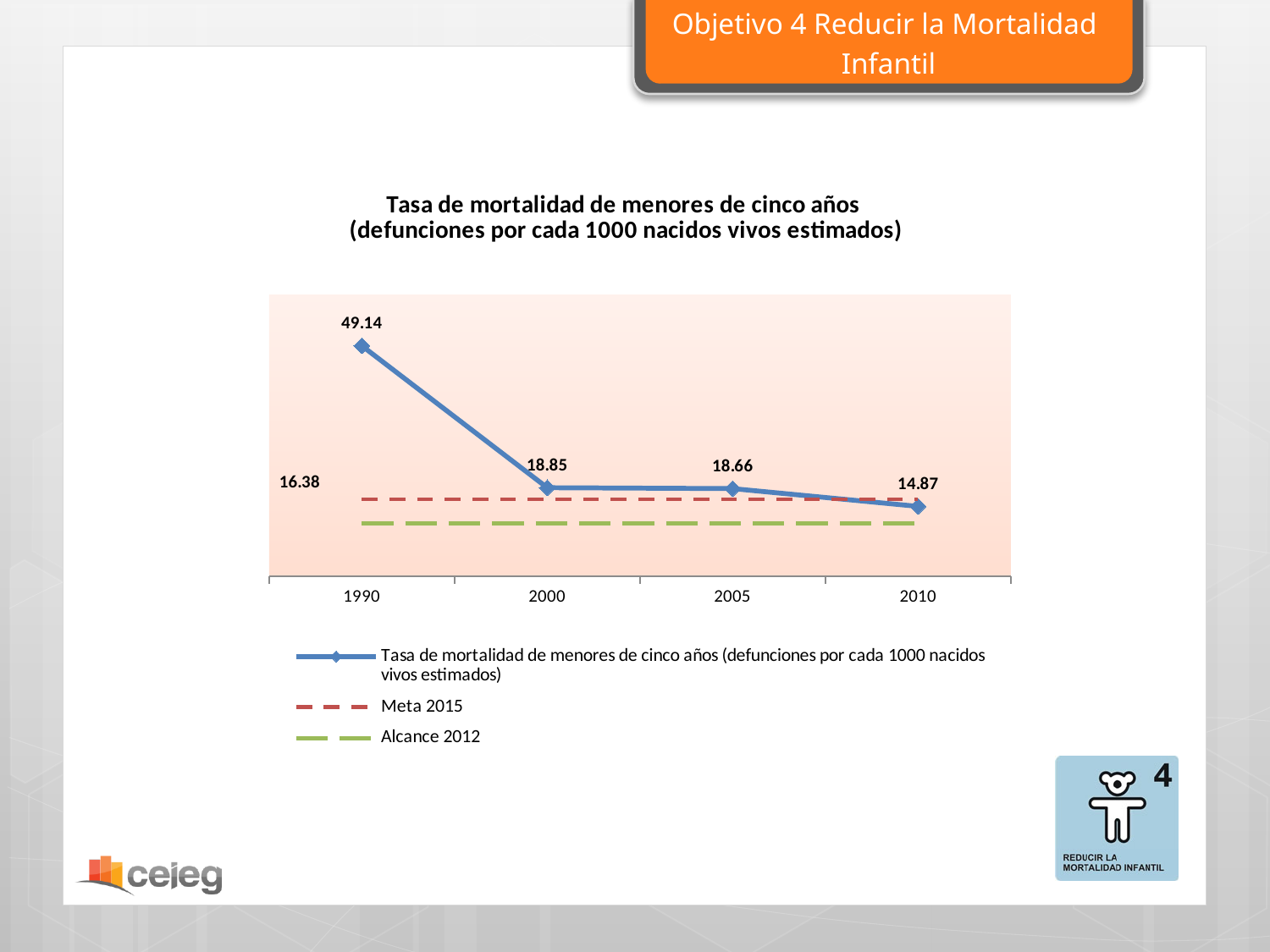
What is the under-five mortality rate shown for 2000? 18.85 How many series does the chart legend list? 3 What is the under-five mortality rate shown for 2010? 14.87 Does the under-five mortality rate rise or fall from 1990 to 2010? fall How many years are plotted on the x axis of the chart? 4 What is the under-five mortality rate shown for 2005? 18.66 Which year has the lowest under-five mortality rate on the chart? 2010 What is the under-five mortality rate shown for 1990? 49.14 Which year has the highest under-five mortality rate on the chart? 1990 Is the under-five mortality rate higher in 2000 or in 2010? 2000 What value is labelled for the Meta 2015 line? 16.38 What is the difference between the under-five mortality rate in 1990 and in 2000? 30.29